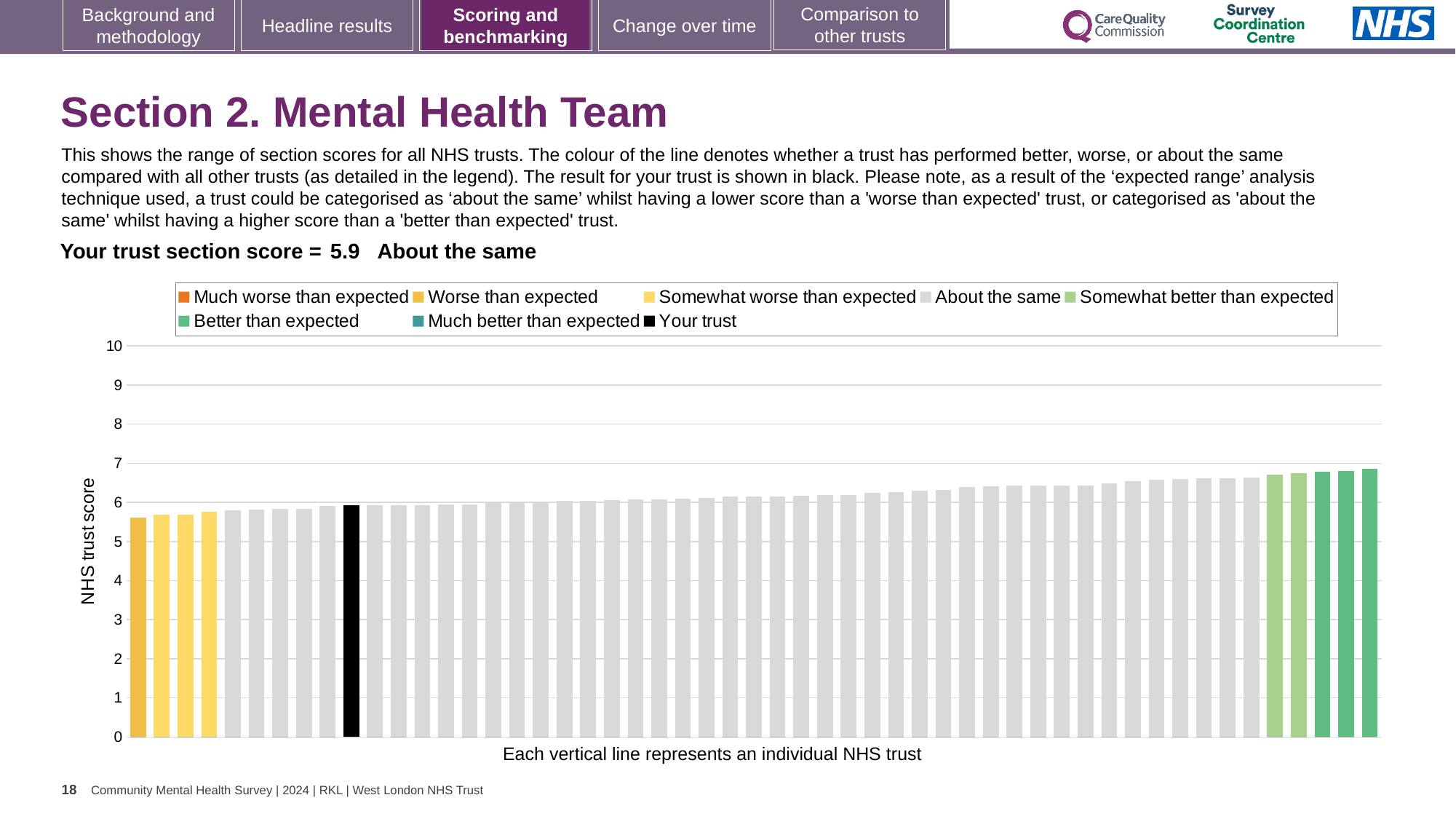
What colour is the bar representing your trust in the chart? black Do the bar values rise or fall from left to right along the x axis? rise What kind of chart is shown on the slide? bar chart Is the value for your trust (the black bar) greater or less than 5? greater How is your trust's performance categorised on the slide? About the same Is the highest bar in the chart greater or less than 7? less Is the value for your trust greater or less than 8? less How many entries does the chart legend list? 8 What is the maximum value shown on the vertical axis of the chart? 10 What is the label on the vertical axis of the chart? NHS trust score What is the section score for your trust shown on the slide? 5.9